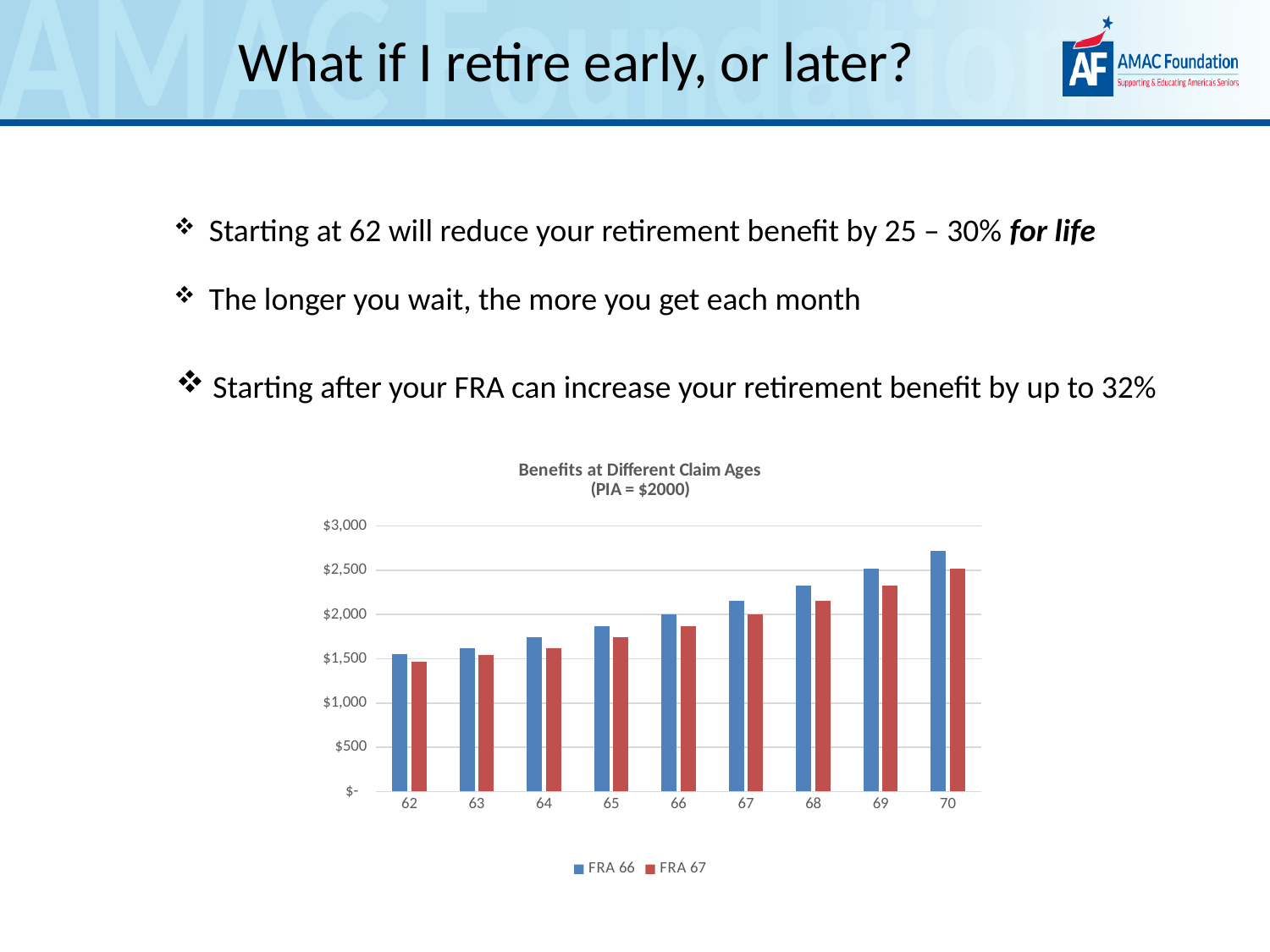
Which two series are listed in the chart legend? FRA 66 and FRA 67 How many series does the chart legend list? 2 At which claim age is the FRA 67 benefit lowest? 62 How many claim ages are shown on the x axis of the chart? 9 Do the benefit values rise or fall as the claim age increases from 62 to 70? rise Is the FRA 67 benefit at claim age 69 greater or less than $2,000? greater At claim age 70, which series has the larger benefit, FRA 66 or FRA 67? FRA 66 At which claim age is the FRA 66 benefit highest? 70 What kind of chart is shown on the slide? bar chart Is the FRA 66 benefit at claim age 70 greater or less than $2,500? greater What is the title of the chart? Benefits at Different Claim Ages (PIA = $2000)